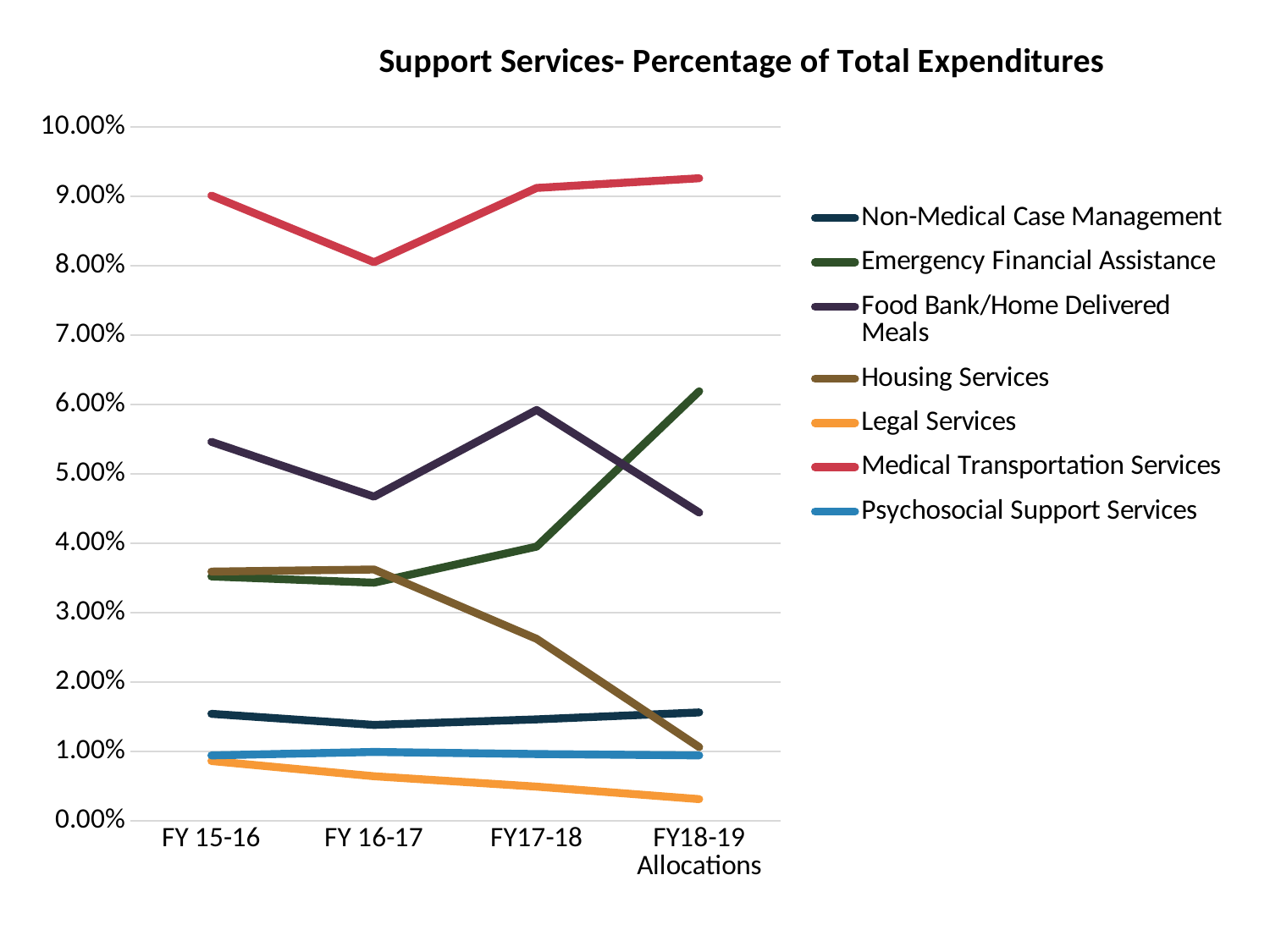
How many fiscal-year categories are shown on the x axis? 4 Which series has the highest value in FY 15-16? Medical Transportation Services In FY17-18, which is larger: Food Bank/Home Delivered Meals or Emergency Financial Assistance? Food Bank/Home Delivered Meals Does the Legal Services line rise or fall from FY 15-16 to FY18-19 Allocations? Fall What is the title of the chart? Support Services- Percentage of Total Expenditures How many series does the legend list? 7 Is the value for Medical Transportation Services in FY 16-17 greater or less than 9.00%? less Is the value for Emergency Financial Assistance in FY18-19 Allocations greater or less than 5.00%? greater What kind of chart is shown on the slide? Line chart Which series has the lowest value in FY18-19 Allocations? Legal Services In FY18-19 Allocations, which is larger: Emergency Financial Assistance or Food Bank/Home Delivered Meals? Emergency Financial Assistance Is the value for Housing Services in FY18-19 Allocations greater or less than 2.00%? less